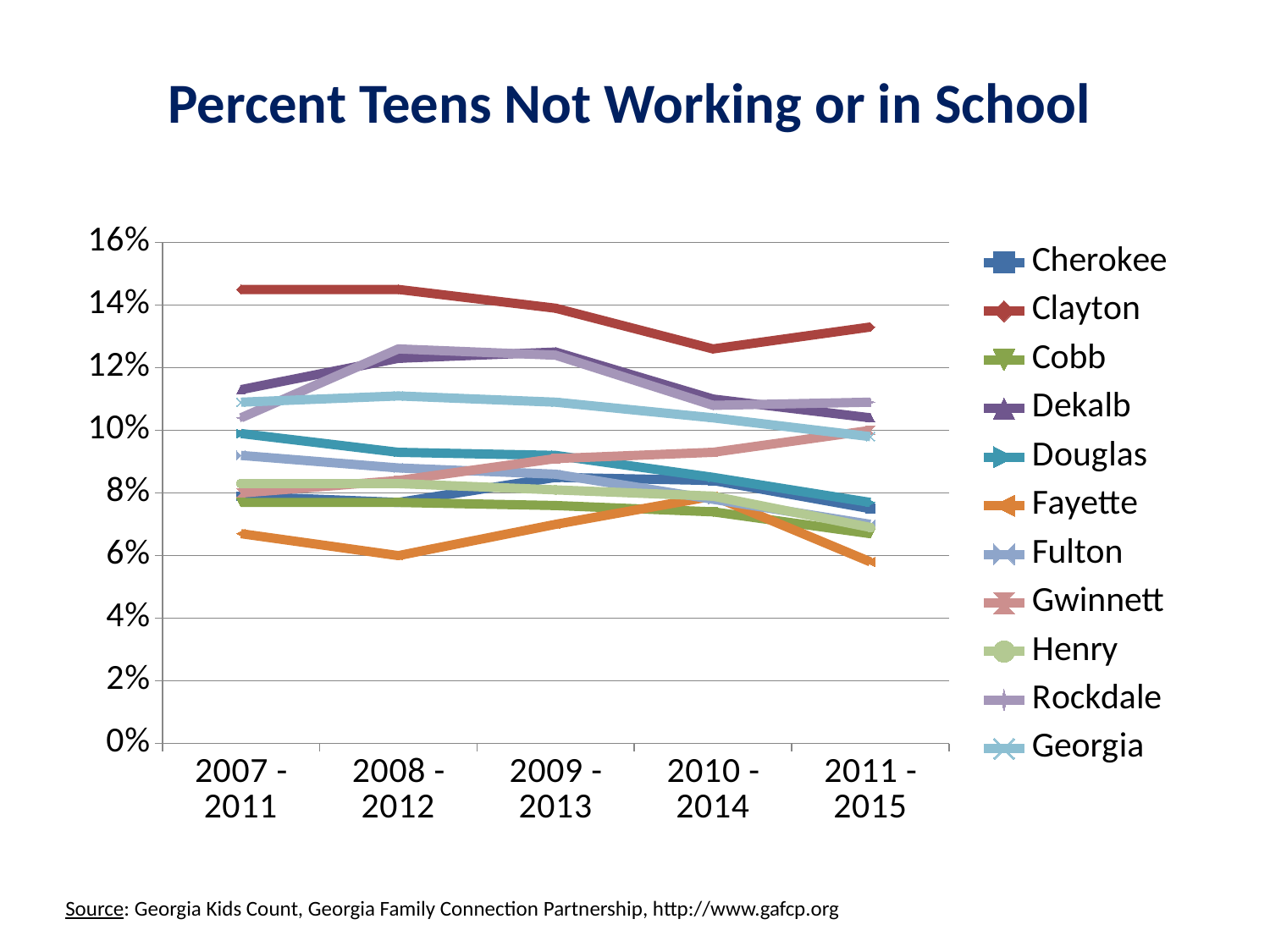
Is the value for Rockdale in 2008 - 2012 greater or less than 12%? greater Which county has the lowest value in 2007 - 2011? Fayette In 2011 - 2015, which is larger, the value for Gwinnett or the value for Fayette? Gwinnett How many time periods are shown on the x axis? 5 Which county has the lowest value in 2011 - 2015? Fayette What is the title of the chart? Percent Teens Not Working or in School Does the value for Gwinnett rise or fall from 2007 - 2011 to 2011 - 2015? Rises How many series does the legend list? 11 Is the value for Clayton in 2007 - 2011 greater or less than 14%? greater Is the value for Fayette in 2007 - 2011 greater or less than 8%? less What kind of chart is shown on the slide? Line chart Which county has the highest value in 2011 - 2015? Clayton